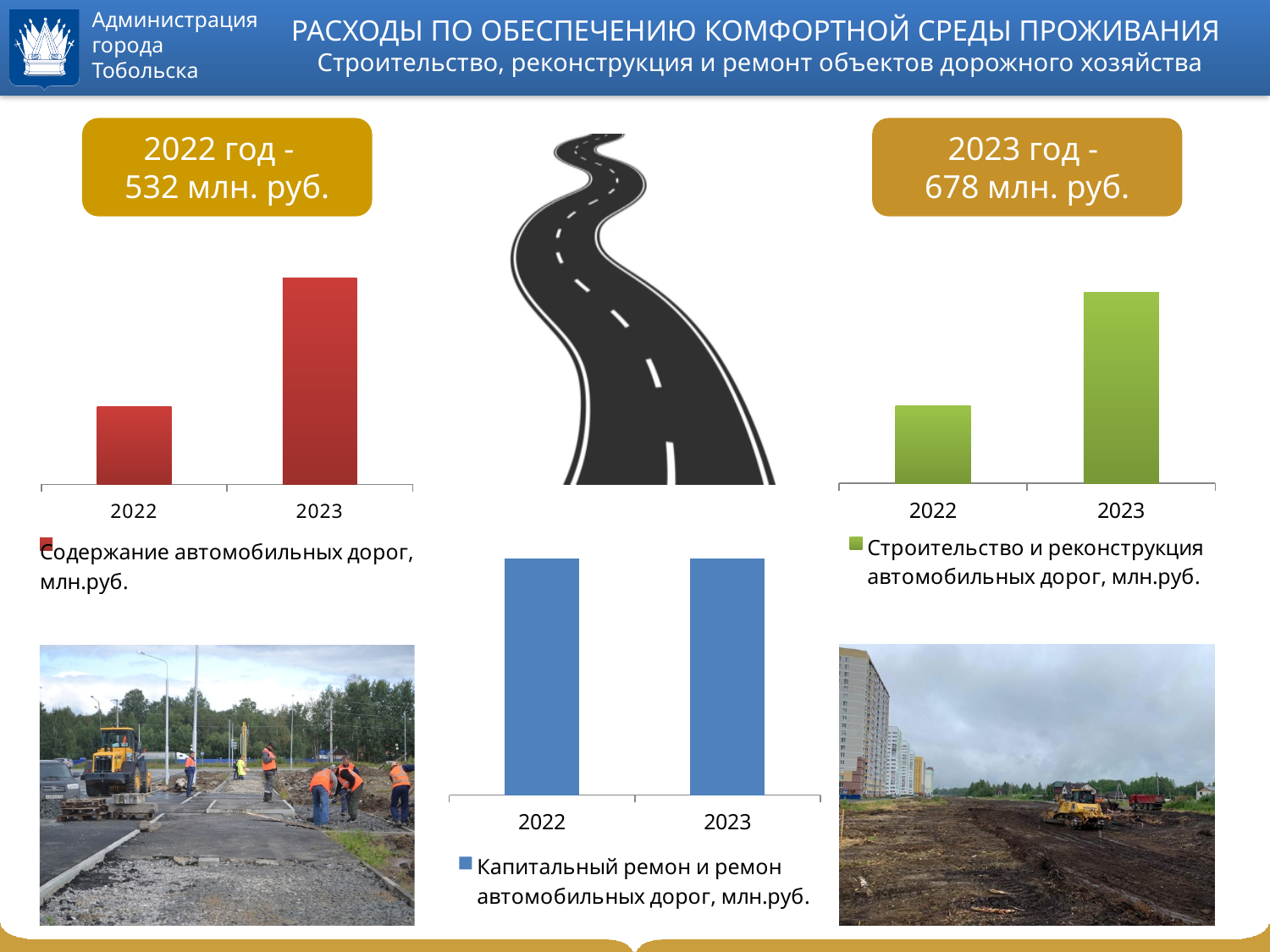
In the left chart (Содержание автомобильных дорог), do the values rise or fall from 2022 to 2023? rise In the right chart (Строительство и реконструкция автомобильных дорог), which year has the lower bar? 2022 What kind of chart is the right chart (Строительство и реконструкция автомобильных дорог)? bar chart In the left chart (Содержание автомобильных дорог), which year has the lower bar? 2022 In the left chart (Содержание автомобильных дорог), is the value for 2023 larger or smaller than the value for 2022? larger What colour are the bars in the middle chart (Капитальный ремон и ремон автомобильных дорог)? blue How many categories are shown on the x axis of the middle chart (Капитальный ремон и ремон автомобильных дорог)? 2 In the left chart (Содержание автомобильных дорог), which year has the higher bar? 2023 In the right chart (Строительство и реконструкция автомобильных дорог), do the values rise or fall from 2022 to 2023? rise What is the legend entry of the left chart on the slide? Содержание автомобильных дорог, млн.руб. In the right chart (Строительство и реконструкция автомобильных дорог), which year has the higher bar? 2023 How many series does the legend of the middle chart (Капитальный ремон и ремон автомобильных дорог) list? 1